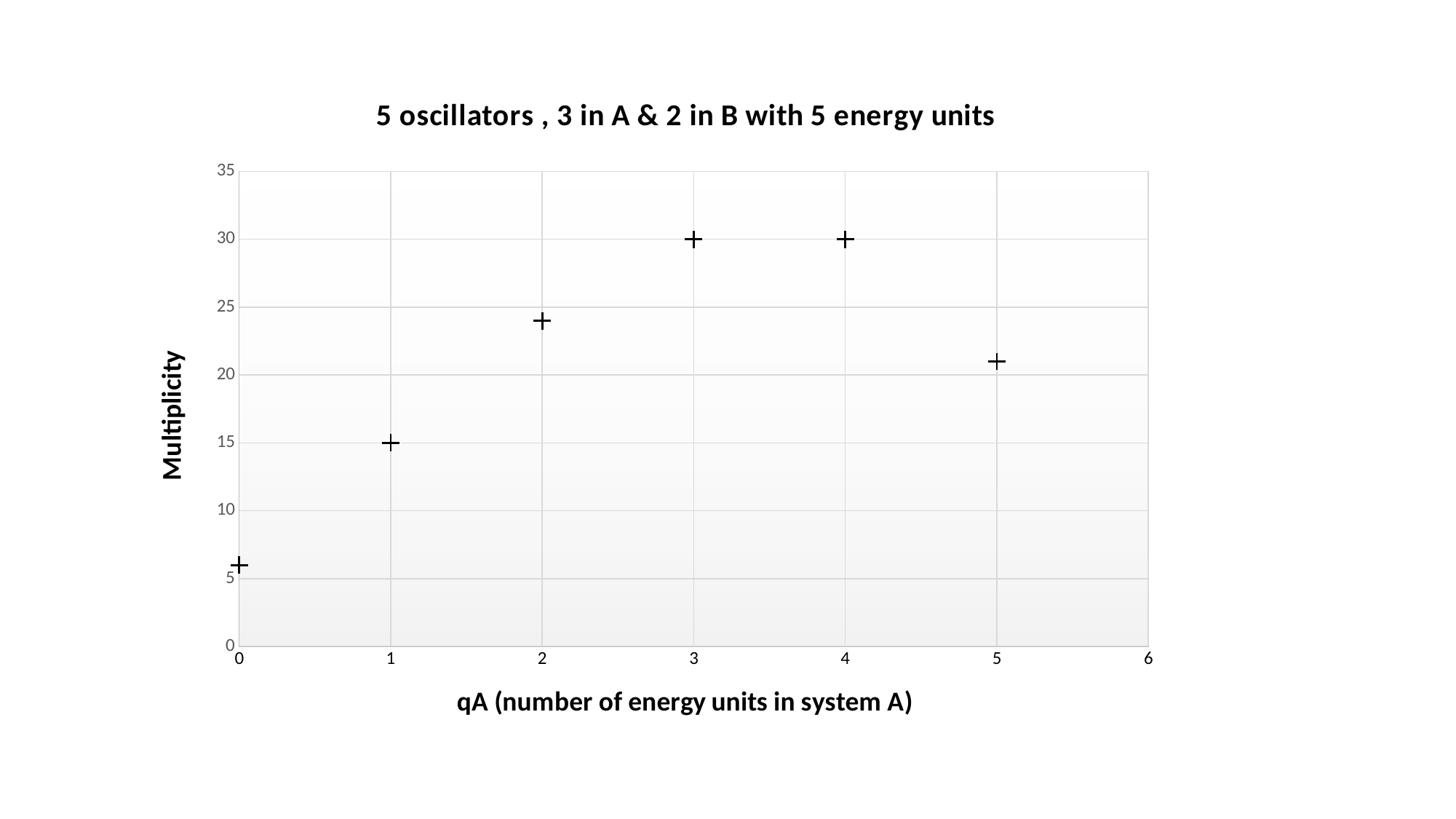
Do the multiplicity values rise or fall as qA goes from 0 to 3? rise What is the multiplicity at qA = 3? 30 What kind of chart is shown on the slide? Scatter plot Which value of qA has the lowest multiplicity? 0 What is the multiplicity at qA = 1? 15 How many data points are plotted on the chart? 6 What is the multiplicity at qA = 4? 30 Is the multiplicity at qA = 5 greater or less than 20? greater Which has the larger multiplicity, qA = 2 or qA = 5? qA = 2 Is the multiplicity at qA = 0 greater or less than 10? less What is the difference between the multiplicity at qA = 3 and at qA = 1? 15 Is the multiplicity at qA = 2 greater or less than 25? less